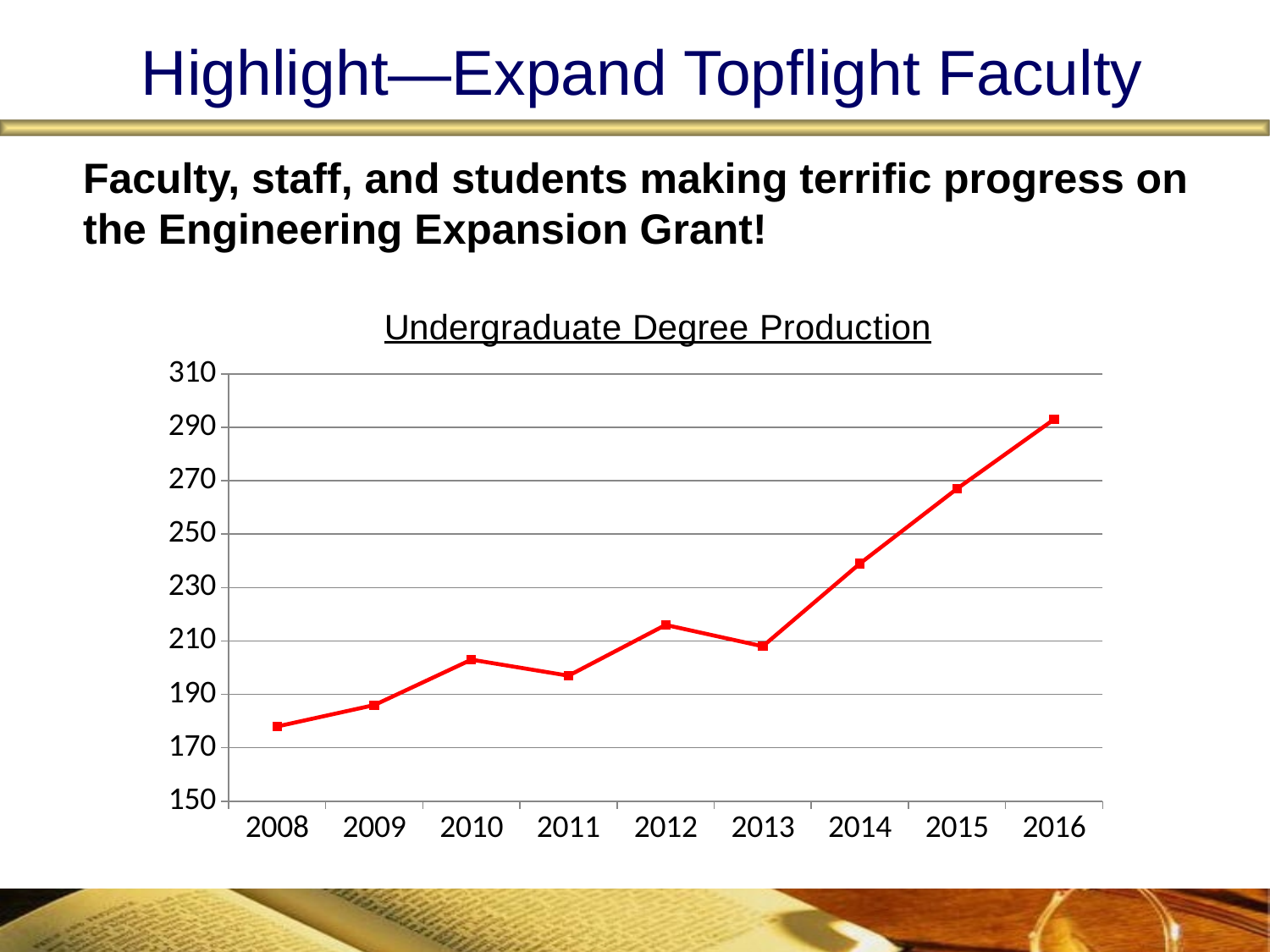
Is the value for 2011 greater or less than 210? less Is the value for 2016 greater or less than 270? greater Which year has the highest undergraduate degree production? 2016 What colour is the line in the chart? Red How many years are plotted on the x axis of the chart? 9 Is the value for 2008 greater or less than 190? less What kind of chart is shown on the slide? Line chart Do the values generally rise or fall from 2008 to 2016? rise Which year has the lowest undergraduate degree production? 2008 Which year has the larger value, 2012 or 2011? 2012 What is the title of the chart? Undergraduate Degree Production